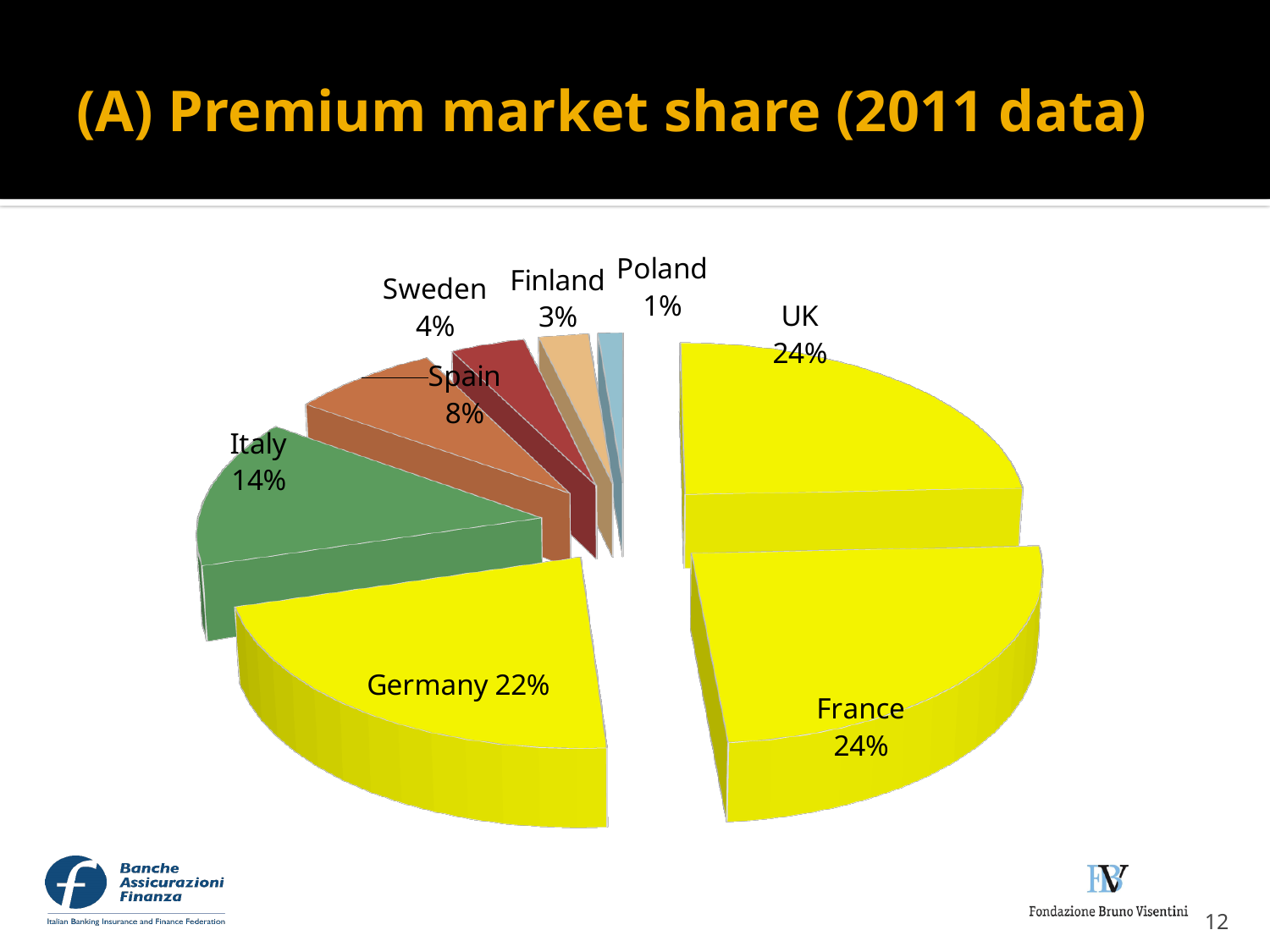
Which has a larger share, Sweden or Finland? Sweden What kind of chart is shown on the slide? pie chart What is the premium market share for Italy? 14% What is the difference between the shares of Spain and Sweden? 4% What is the title of the slide containing the pie chart? (A) Premium market share (2011 data) What is the premium market share for Germany? 22% What is the difference between the shares of Germany and Italy? 8% Which has a larger share, Italy or Spain? Italy Which country has the smallest share in the pie chart? Poland What is the premium market share for Finland? 3% How many countries are shown in the pie chart? 8 What is the premium market share for Spain? 8%